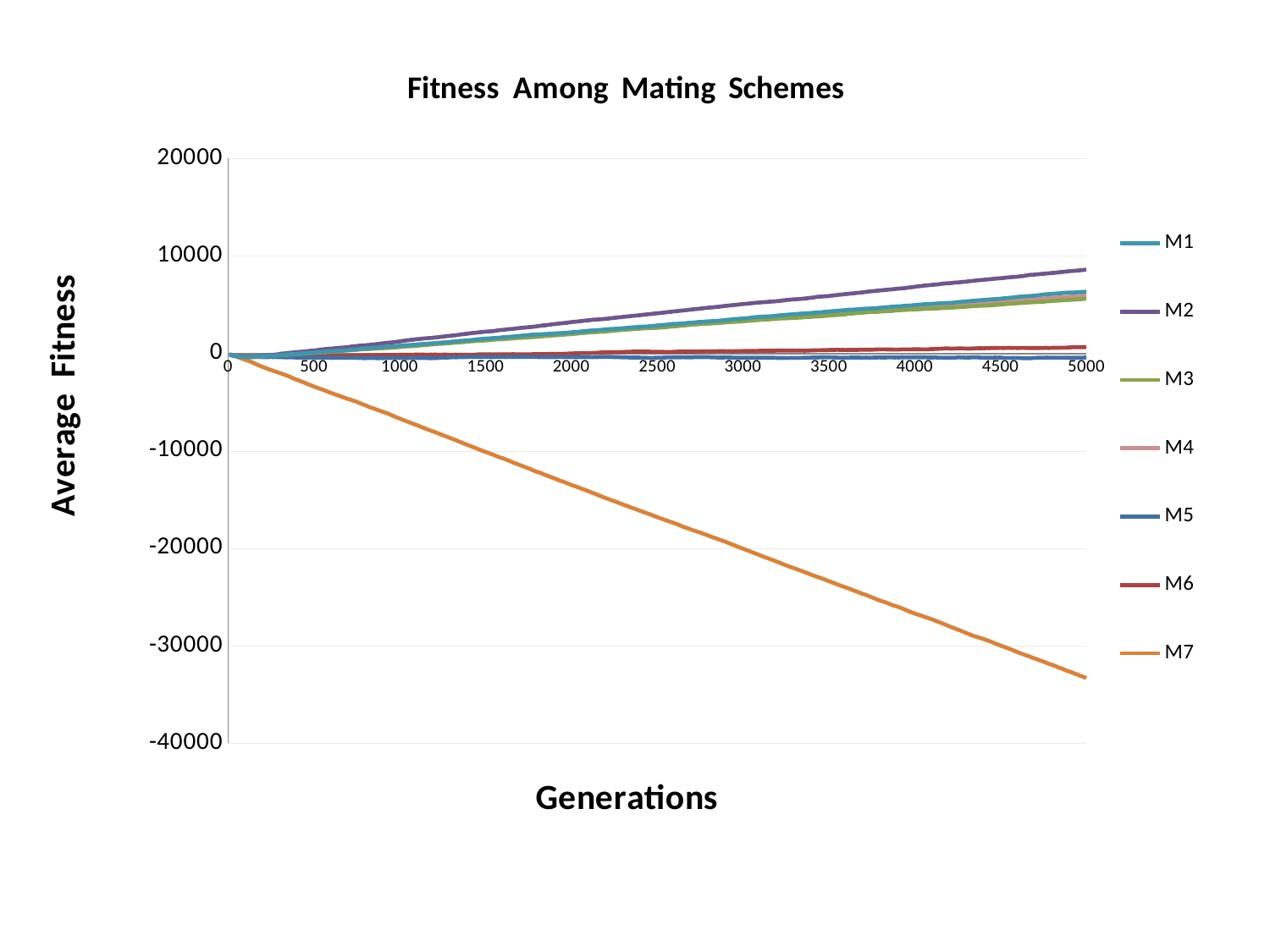
Does the average fitness for M2 rise or fall as generations increase? rise What is the label of the vertical axis? Average Fitness Is the value for M7 at generation 5000 greater or less than -30000? less Which series has the lowest average fitness at generation 5000? M7 What kind of chart is shown on the slide? line chart How many series does the legend list? 7 At generation 5000, which series has the larger average fitness, M2 or M6? M2 Is the value for M2 at generation 5000 greater or less than 10000? less What is the title of the chart? Fitness Among Mating Schemes Does the average fitness for M7 rise or fall as generations increase? fall Is the value for M2 at generation 5000 greater or less than 5000? greater Which series has the highest average fitness at generation 5000? M2